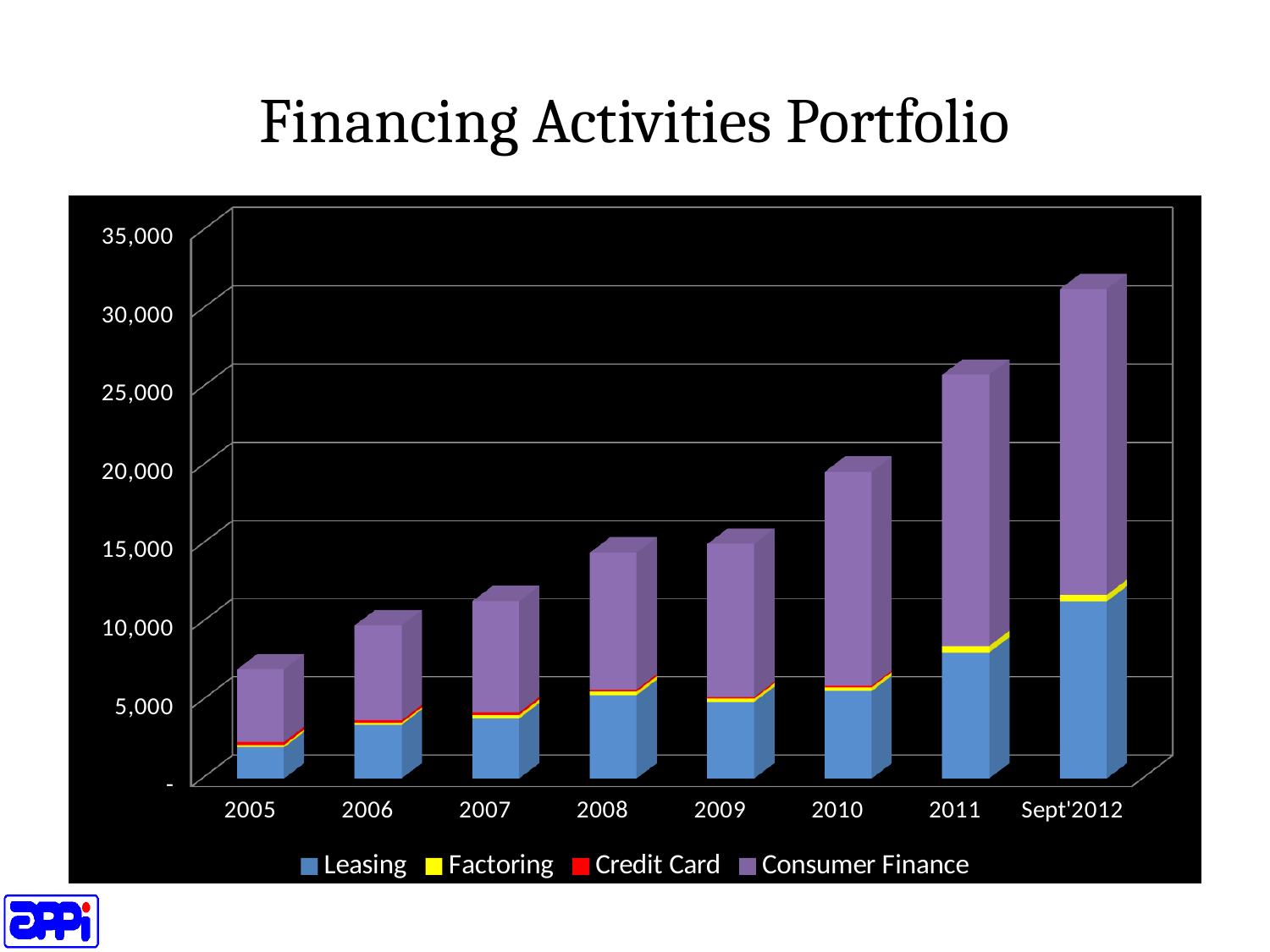
Which period has the tallest stacked bar? Sept'2012 What is the title of the chart? Financing Activities Portfolio Is the total value for 2010 greater or less than 15,000? greater How many series does the legend list? 4 Is the total value for Sept'2012 greater or less than 25,000? greater Which is larger in 2011, the Consumer Finance segment or the Leasing segment? Consumer Finance What kind of chart is shown on the slide? Stacked bar chart How many periods are shown along the x axis? 8 Is the total value for 2005 greater or less than 10,000? less Which colour represents Consumer Finance in the legend? Purple Do the total bar heights rise or fall from 2005 to Sept'2012? Rise Which period has the shortest stacked bar? 2005